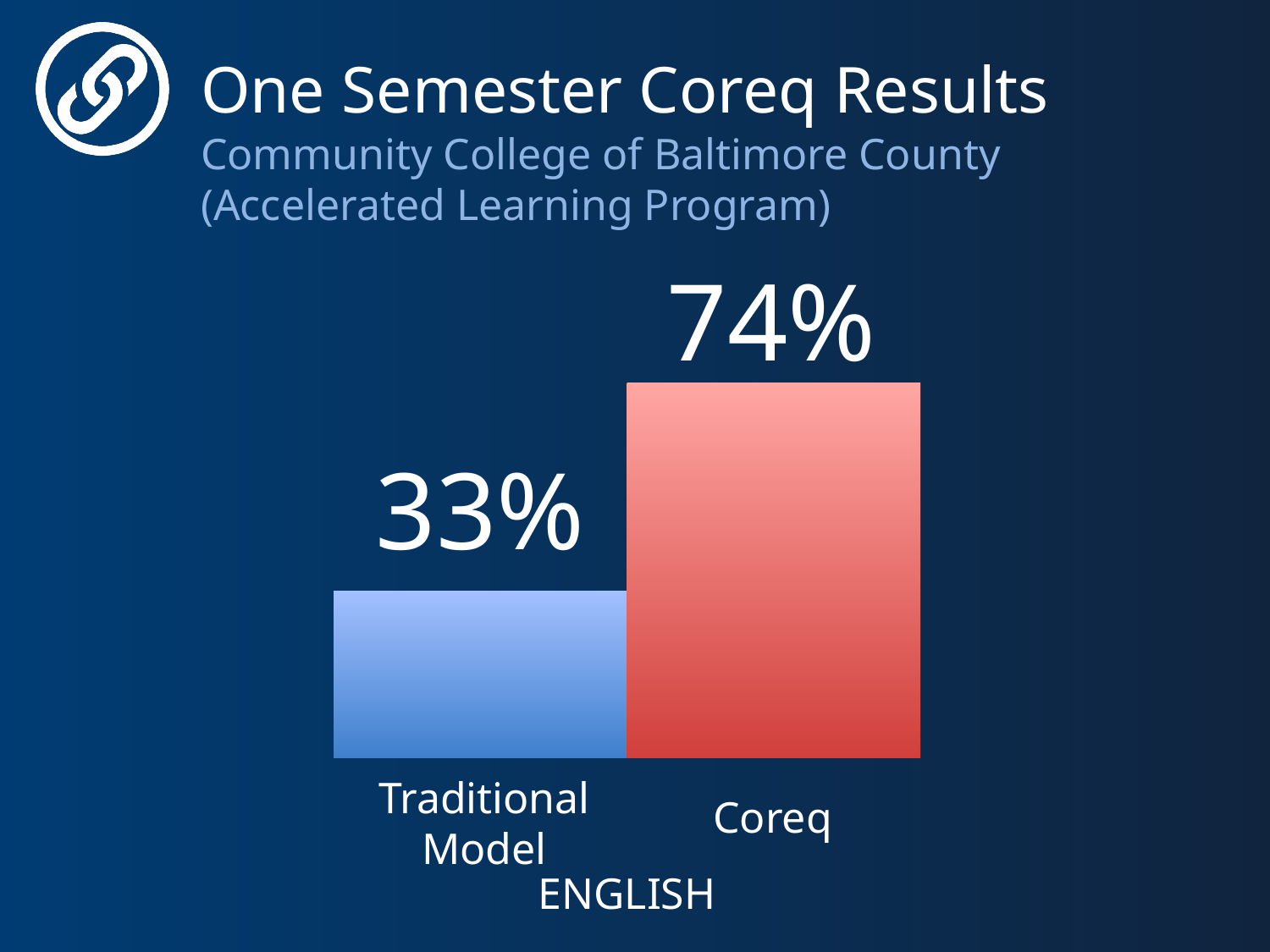
What kind of chart is shown on the slide? Bar chart What is the value for the Traditional Model bar? 33% What is the value for the Coreq bar? 74% Which is larger, the value for Traditional Model or the value for Coreq? Coreq Which category has the highest value? Coreq What colour is the Coreq bar? Red What is the difference between the Coreq value and the Traditional Model value? 41% Which category has the lowest value? Traditional Model What subject is labelled beneath the bars? ENGLISH How many bars are shown in the chart? 2